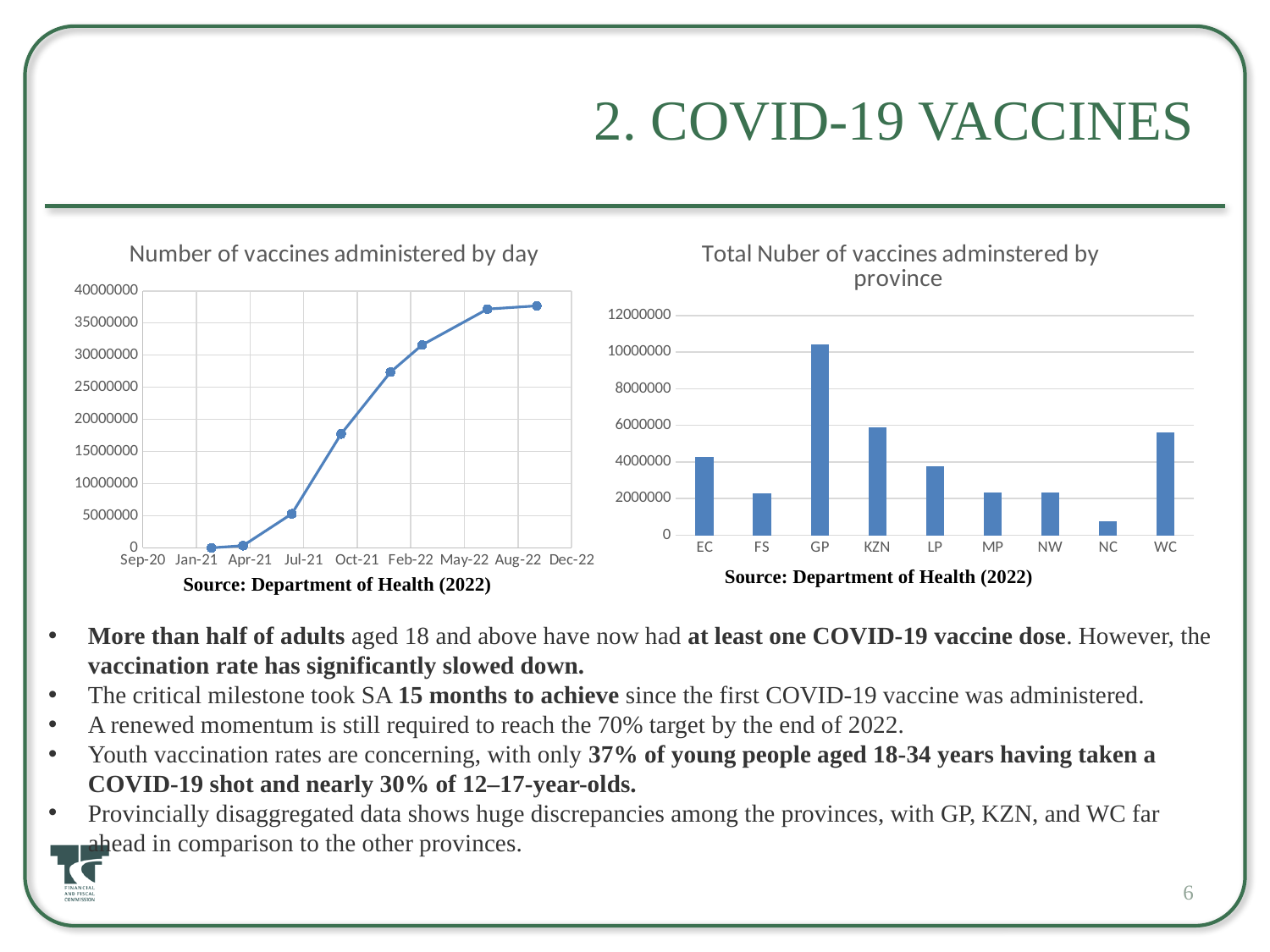
On the 'Total Nuber of vaccines adminstered by province' chart, which is larger, the value for GP or the value for KZN? GP On the 'Number of vaccines administered by day' chart, do the values rise or fall over time? rise On the 'Total Nuber of vaccines adminstered by province' chart, how many provinces are shown? 9 On the 'Total Nuber of vaccines adminstered by province' chart, is the value for LP greater or less than 4000000? less What kind of chart is the 'Total Nuber of vaccines adminstered by province' chart? bar chart On the 'Number of vaccines administered by day' chart, is the value at Oct-21 greater or less than 15000000? greater What kind of chart is the 'Number of vaccines administered by day' chart? line chart On the 'Total Nuber of vaccines adminstered by province' chart, which province has the lowest total? NC On the 'Total Nuber of vaccines adminstered by province' chart, which is larger, the value for EC or the value for FS? EC On the 'Total Nuber of vaccines adminstered by province' chart, which province has the highest total? GP On the 'Total Nuber of vaccines adminstered by province' chart, is the value for GP greater or less than 8000000? greater